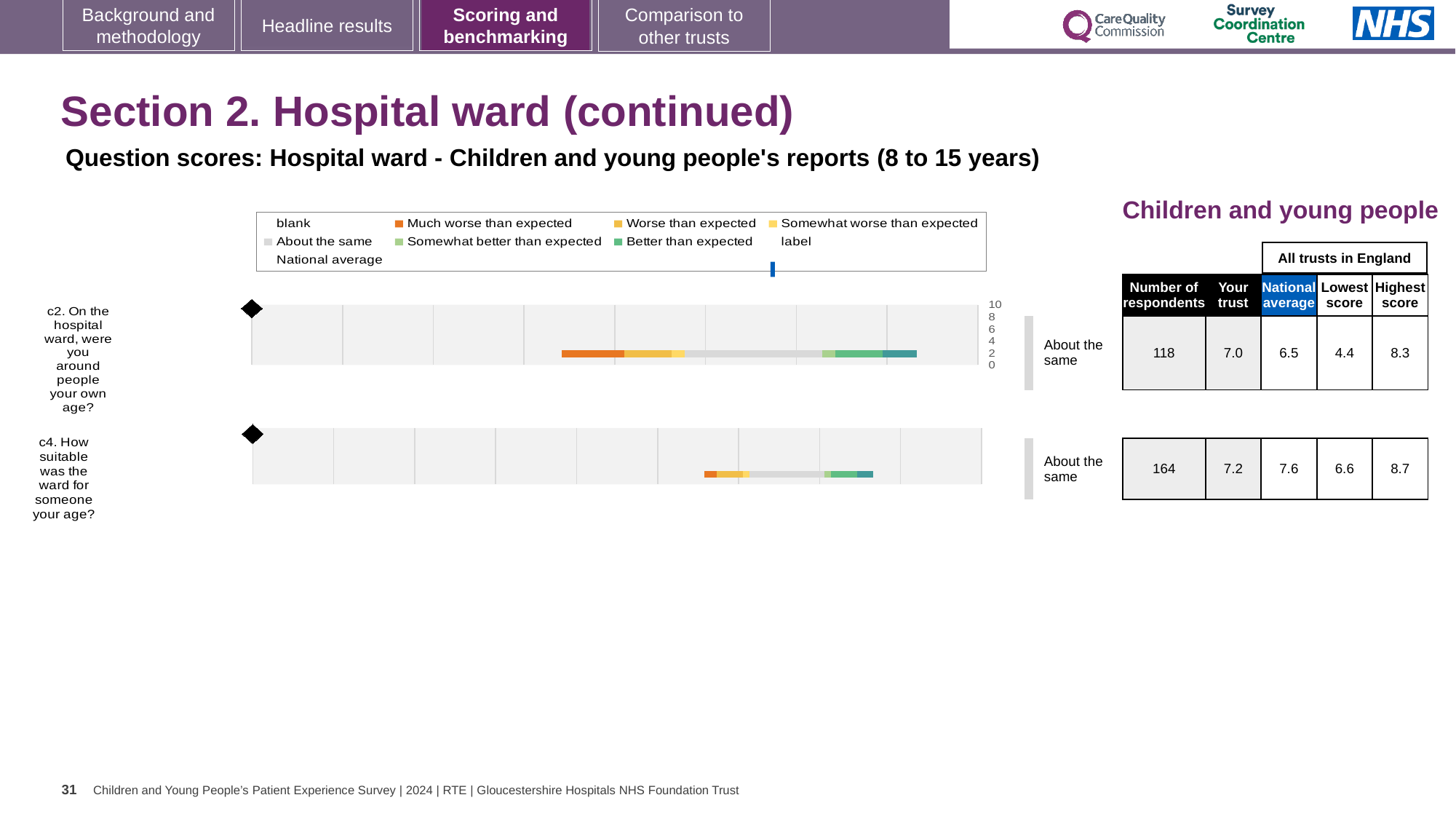
What benchmark rating is shown next to the chart for question c2? About the same What is the highest score among all trusts in England for question c4? 8.7 How many questions are plotted on the slide? 2 What is the lowest score among all trusts in England for question c2? 4.4 For question c2, is the 'Your trust' score higher or lower than the national average? higher What is the 'Your trust' score for question c4 (How suitable was the ward for someone your age?)? 7.2 Which question has more respondents, c2 or c4? c4 For question c4, how much higher is the national average than the 'Your trust' score? 0.4 What is the difference between the highest and lowest scores for question c2? 3.9 How many respondents are recorded for question c2 (On the hospital ward, were you around people your own age?)? 118 What kind of chart is used to show the question scores for c2 and c4? bar chart What is the national average score for question c2? 6.5